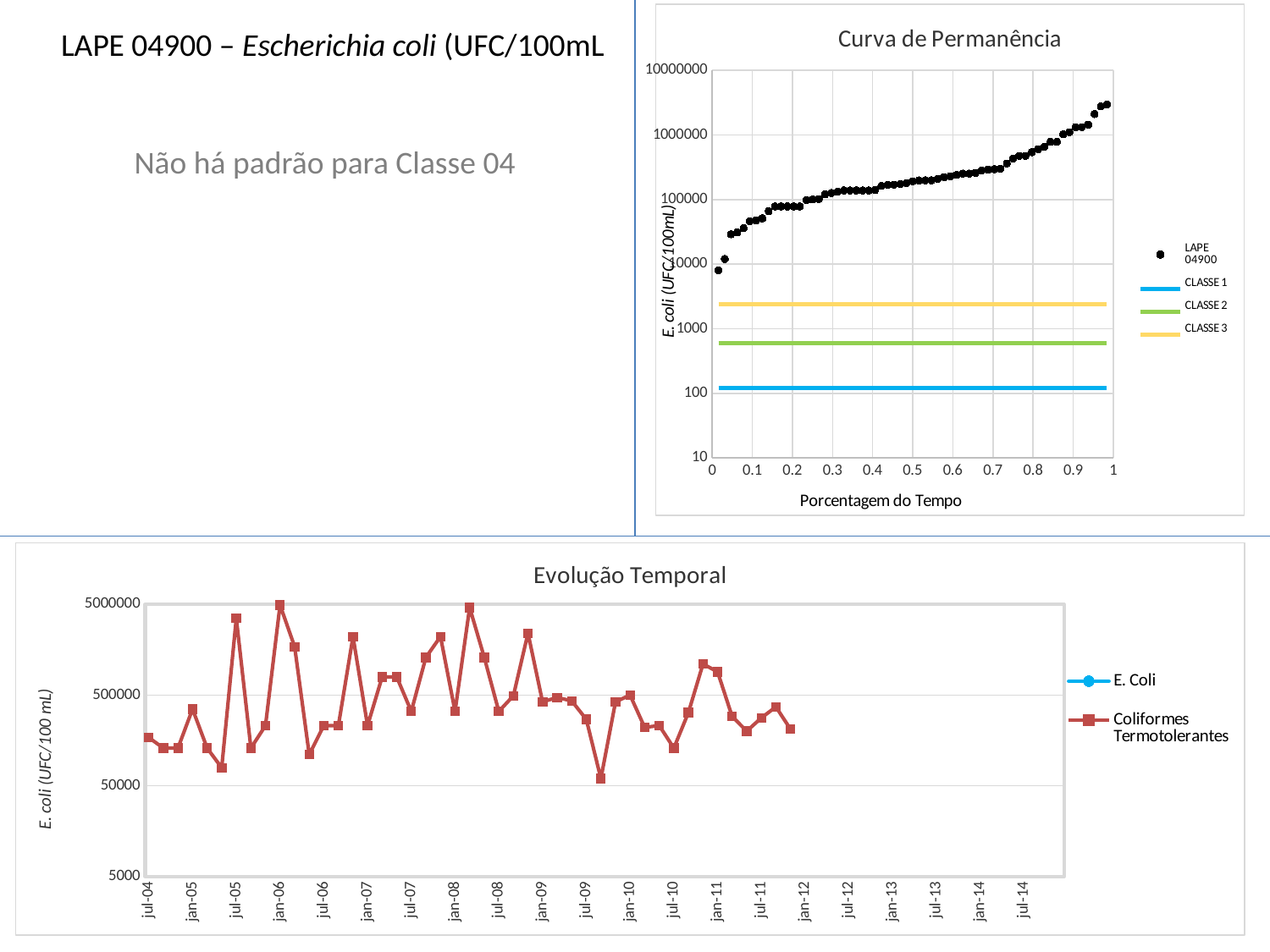
In the 'Evolução Temporal' chart, is the Coliformes Termotolerantes value at jan-06 greater or less than 500000? greater In the 'Curva de Permanência' chart, is the CLASSE 2 line greater or less than 1000? less In the 'Curva de Permanência' chart, how many series does the legend list? 4 What kind of chart is 'Evolução Temporal'? Line chart In the 'Curva de Permanência' chart, which of the three class lines is the lowest? CLASSE 1 In the 'Curva de Permanência' chart, which of the three class lines is the highest? CLASSE 3 In the 'Curva de Permanência' chart, is the CLASSE 1 line greater or less than 1000? less In the 'Evolução Temporal' chart, which is larger for Coliformes Termotolerantes: the value at jan-06 or the value at jul-04? jan-06 In the 'Curva de Permanência' chart, do the LAPE 04900 values rise or fall as Porcentagem do Tempo increases? Rise In the 'Evolução Temporal' chart, how many series does the legend list? 2 What is the x-axis title of the 'Curva de Permanência' chart? Porcentagem do Tempo